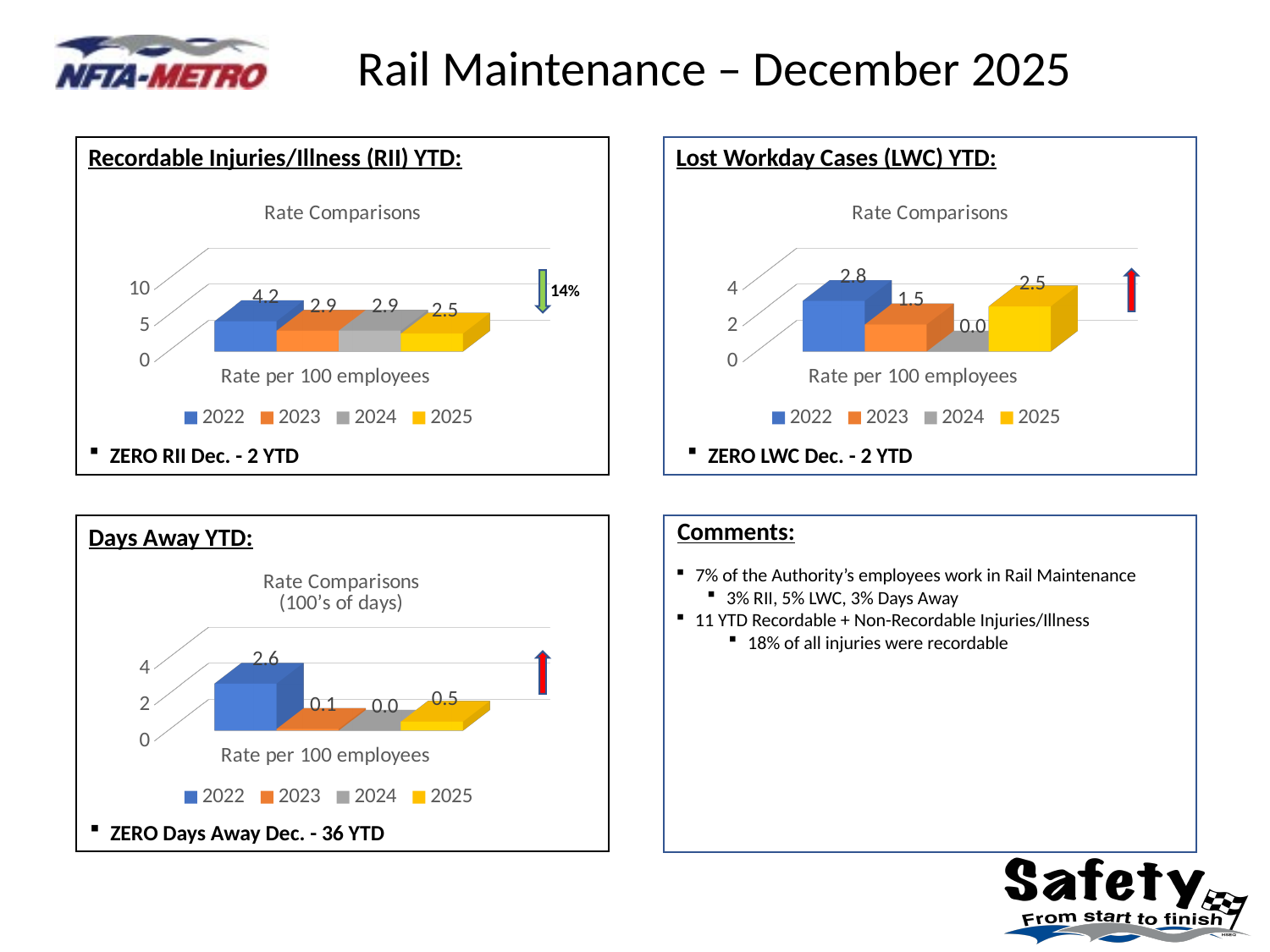
What kind of chart is the Lost Workday Cases (LWC) YTD chart? Bar chart In the Recordable Injuries/Illness (RII) YTD chart, what is the rate per 100 employees for 2022? 4.2 In the Days Away YTD chart, what is the difference between the 2022 and 2023 rates? 2.5 In the Recordable Injuries/Illness (RII) YTD chart, which year has the lowest rate? 2025 In the Lost Workday Cases (LWC) YTD chart, what is the rate per 100 employees for 2023? 1.5 In the Recordable Injuries/Illness (RII) YTD chart, what is the difference between the 2022 and 2025 rates? 1.7 How many series does the legend list in the Days Away YTD chart? 4 In the Lost Workday Cases (LWC) YTD chart, which year has the highest rate? 2022 What is the title of the chart in the Recordable Injuries/Illness (RII) YTD box? Rate Comparisons In the Lost Workday Cases (LWC) YTD chart, which is larger, the 2023 rate or the 2025 rate? 2025 In the Days Away YTD chart, what is the rate per 100 employees for 2025? 0.5 In the Days Away YTD chart, which year has the highest rate? 2022